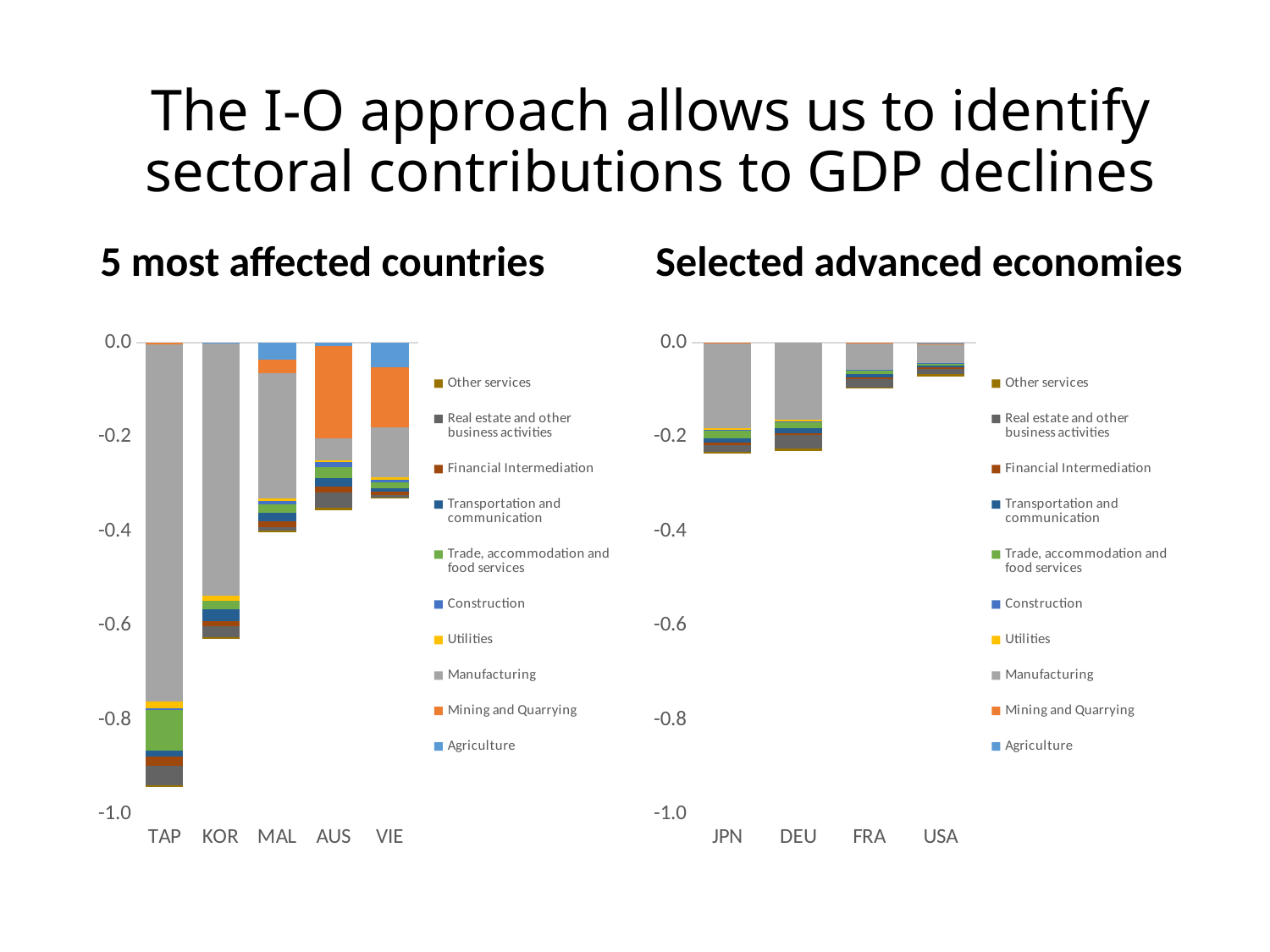
How many countries are shown on the x axis of the 'Selected advanced economies' chart? 4 In the '5 most affected countries' chart, is the total value for TAP greater or less than -0.8? less In the 'Selected advanced economies' chart, which country has the smallest total GDP decline? USA In the '5 most affected countries' chart, is the total value for AUS greater or less than -0.4? greater In the '5 most affected countries' chart, which has the larger total decline, TAP or KOR? TAP In the '5 most affected countries' chart, which country has the largest total GDP decline? TAP In the '5 most affected countries' chart, which country has the smallest total GDP decline? VIE In the 'Selected advanced economies' chart, is the total value for FRA greater or less than -0.2? greater How many countries are shown on the x axis of the '5 most affected countries' chart? 5 How many series does the legend of the 'Selected advanced economies' chart list? 10 What kind of chart is the '5 most affected countries' chart? Stacked bar chart In the '5 most affected countries' chart, does the size of the total decline increase or decrease from TAP to VIE? decrease